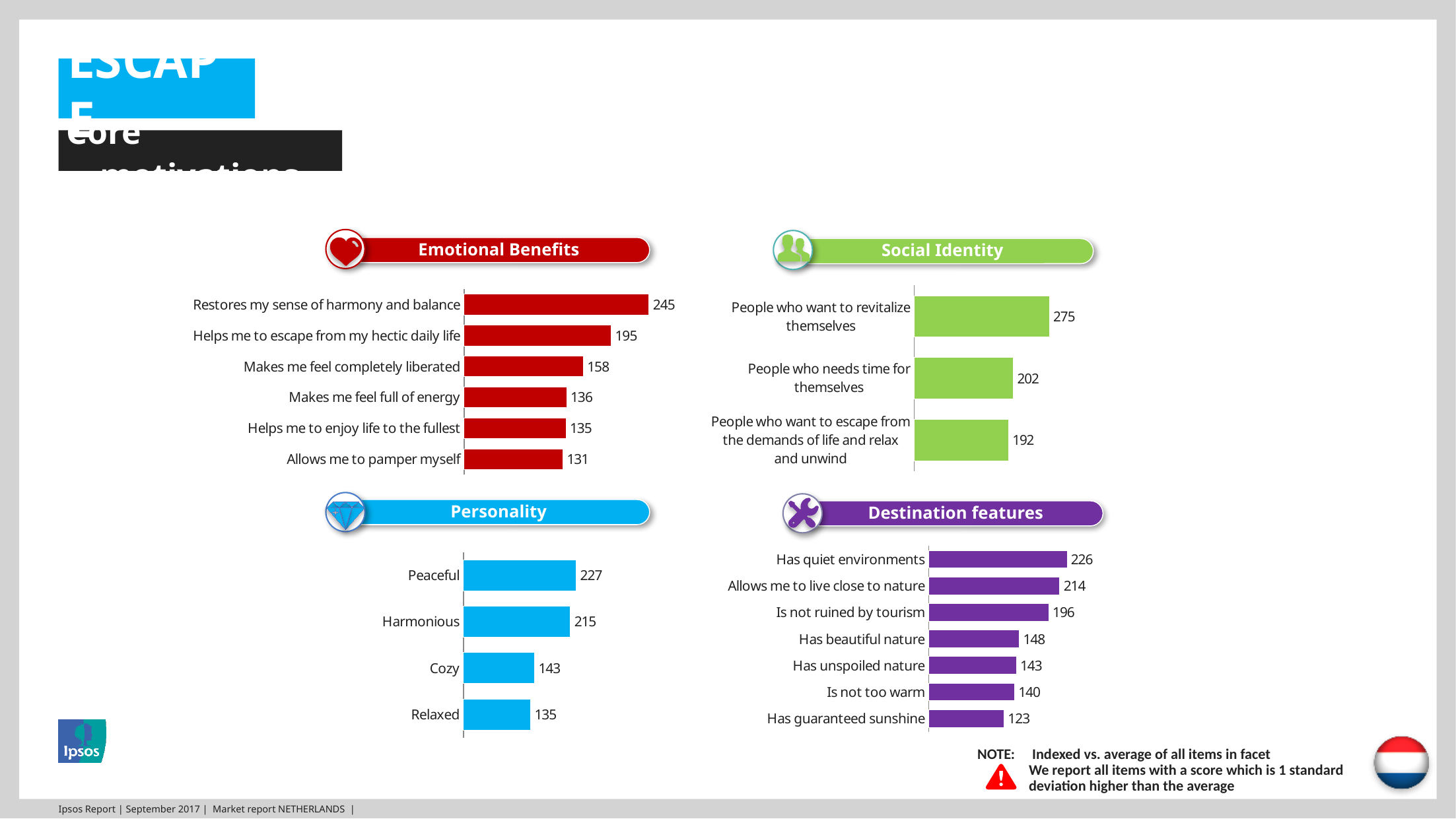
How many categories does the Social Identity chart show? 3 In the Destination features chart, what is the value for "Is not ruined by tourism"? 196 How many categories does the Destination features chart show? 7 What kind of chart is the Personality chart? Bar chart In the Social Identity chart, which category has the highest value? People who want to revitalize themselves In the Social Identity chart, what is the value for "People who needs time for themselves"? 202 In the Destination features chart, which category has the lowest value? Has guaranteed sunshine In the Emotional Benefits chart, what is the difference between "Helps me to escape from my hectic daily life" and "Makes me feel completely liberated"? 37 In the Emotional Benefits chart, which category has the lowest value? Allows me to pamper myself In the Emotional Benefits chart, what is the value for "Restores my sense of harmony and balance"? 245 In the Personality chart, which is larger, "Peaceful" or "Harmonious"? Peaceful In the Personality chart, what is the value for "Cozy"? 143